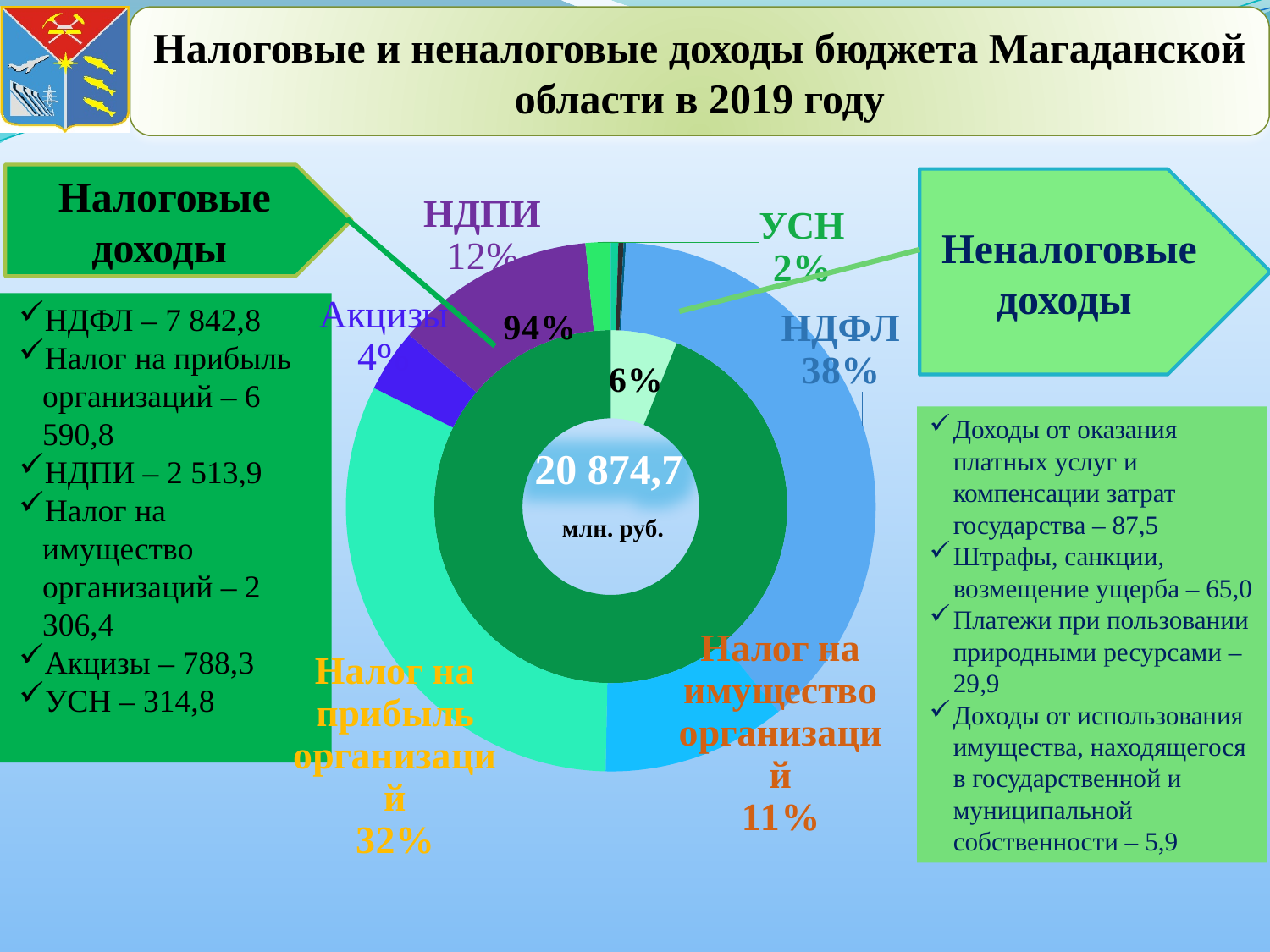
Which labelled category has the largest share in the outer ring? НДФЛ What kind of chart is shown on the slide? doughnut chart What share of the outer ring does НДПИ account for? 12% What share of the outer ring does УСН account for? 2% What total value is printed in the centre of the chart? 20 874,7 млн. руб. What share of the outer ring does Налог на прибыль организаций account for? 32% Which labelled category has the smallest share in the outer ring? УСН Which is larger in the inner ring: the 94% segment or the 6% segment? the 94% segment What is the difference in percentage points between the НДФЛ share and the Налог на прибыль организаций share? 6 percentage points